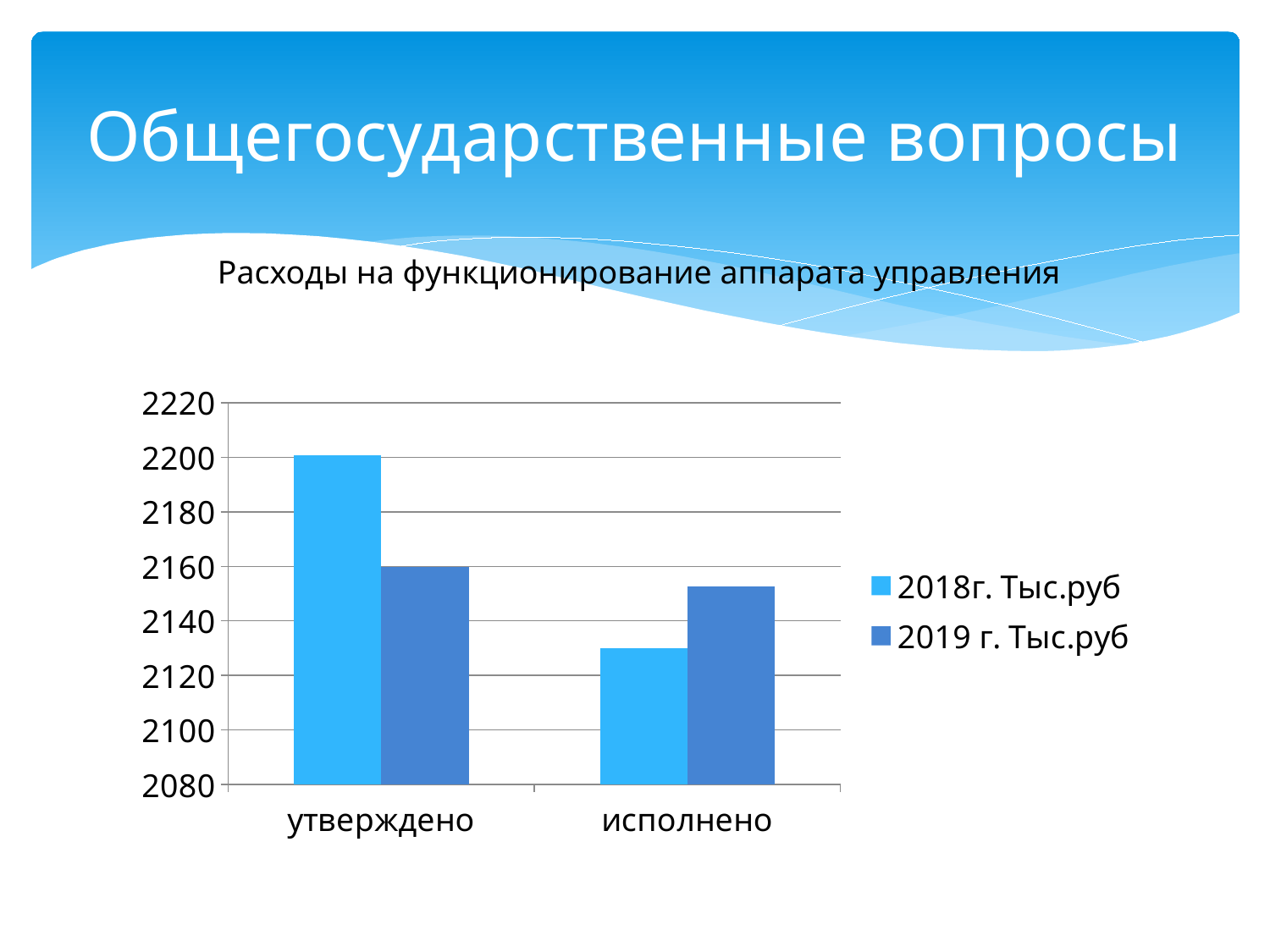
What kind of chart is shown on the slide? bar chart Which category has the lowest bar on the chart? исполнено Is the value for 2018г. Тыс.руб in the исполнено category greater or less than 2140? less In the исполнено category, which series has the larger value, 2018г. Тыс.руб or 2019 г. Тыс.руб? 2019 г. Тыс.руб In the утверждено category, which series has the larger value, 2018г. Тыс.руб or 2019 г. Тыс.руб? 2018г. Тыс.руб What are the two series named in the legend? 2018г. Тыс.руб and 2019 г. Тыс.руб How many categories are shown on the x axis? 2 Is the value for 2019 г. Тыс.руб in the утверждено category greater or less than 2180? less How many series does the legend list? 2 Is the value for 2018г. Тыс.руб in the утверждено category greater or less than 2180? greater What is the subtitle above the chart? Расходы на функционирование аппарата управления